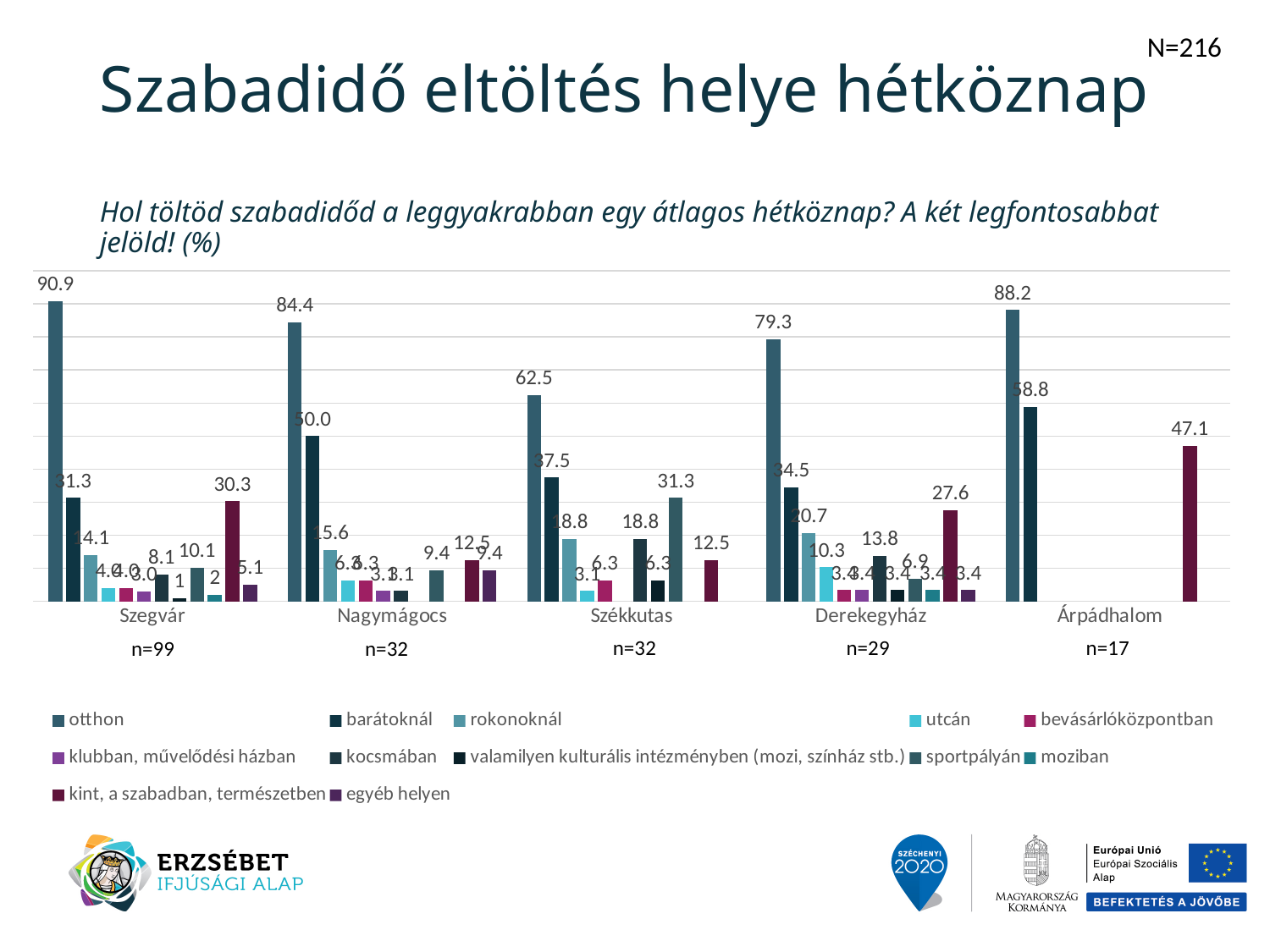
Which is larger: the barátoknál value for Nagymágocs or for Derekegyház? Nagymágocs How many series does the legend list? 12 What kind of chart is shown on the slide? bar chart What is the value for otthon in Szegvár? 90.9 What is the difference between the otthon values for Szegvár and Székkutas? 28.4 What is the value for barátoknál in Árpádhalom? 58.8 What is the value for kint, a szabadban, természetben in Árpádhalom? 47.1 How many settlements are shown on the x axis? 5 Which settlement has the lowest value for otthon? Székkutas Which settlement has the highest value for otthon? Szegvár What is the sample size (n) shown for Szegvár? n=99 What is the value for otthon in Székkutas? 62.5